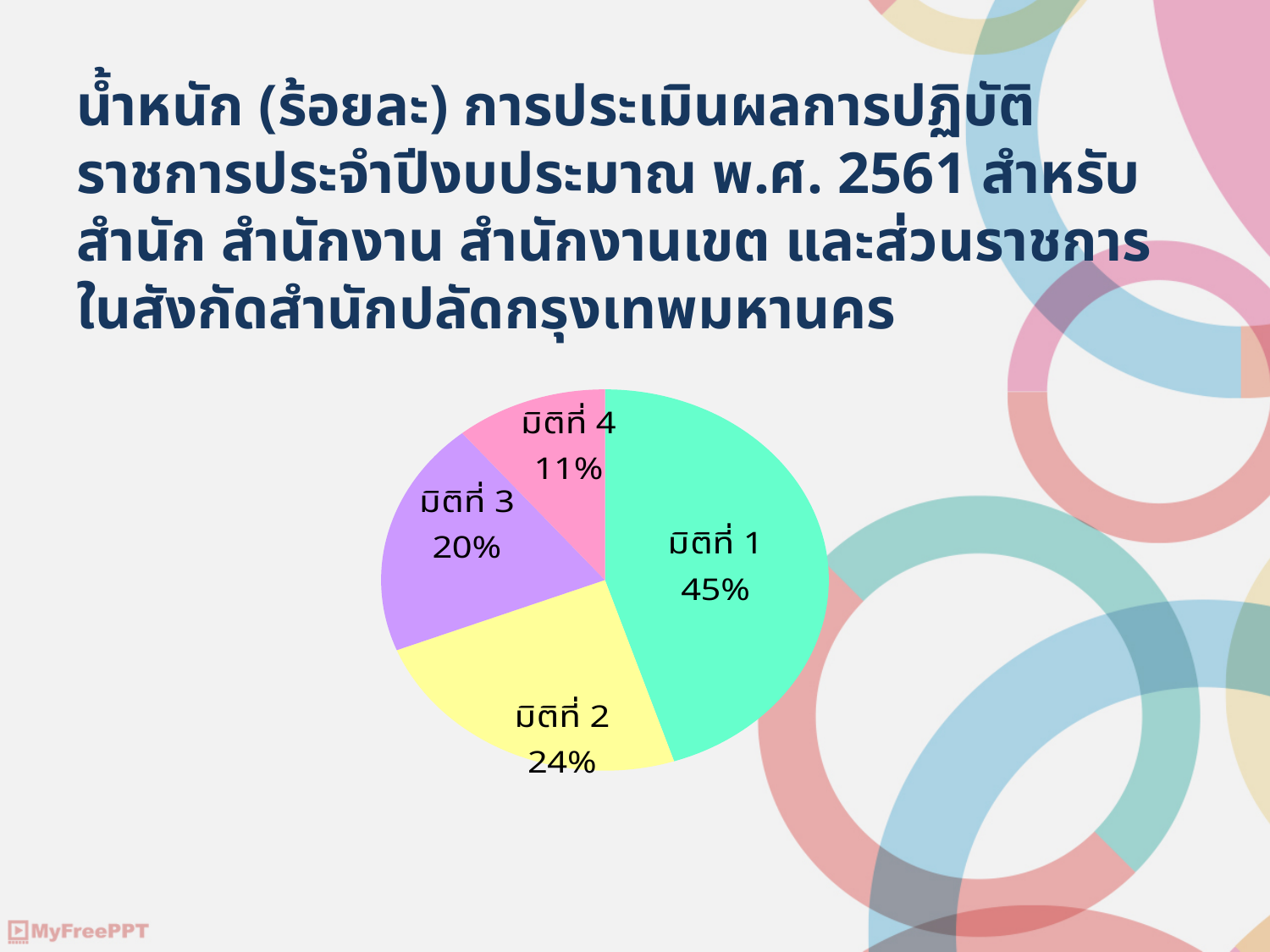
What colour is the slice for มิติที่ 2? yellow What is the share for มิติที่ 2? 24% What is the difference in percentage points between มิติที่ 3 and มิติที่ 4? 9 Which slice has the smallest share? มิติที่ 4 What is the difference in percentage points between มิติที่ 1 and มิติที่ 2? 21 Which is larger, the share for มิติที่ 3 or มิติที่ 4? มิติที่ 3 Which slice has the largest share? มิติที่ 1 What is the share for มิติที่ 1? 45% What kind of chart is shown on the slide? pie chart How many slices does the pie chart have? 4 What is the share for มิติที่ 3? 20% What is the share for มิติที่ 4? 11%